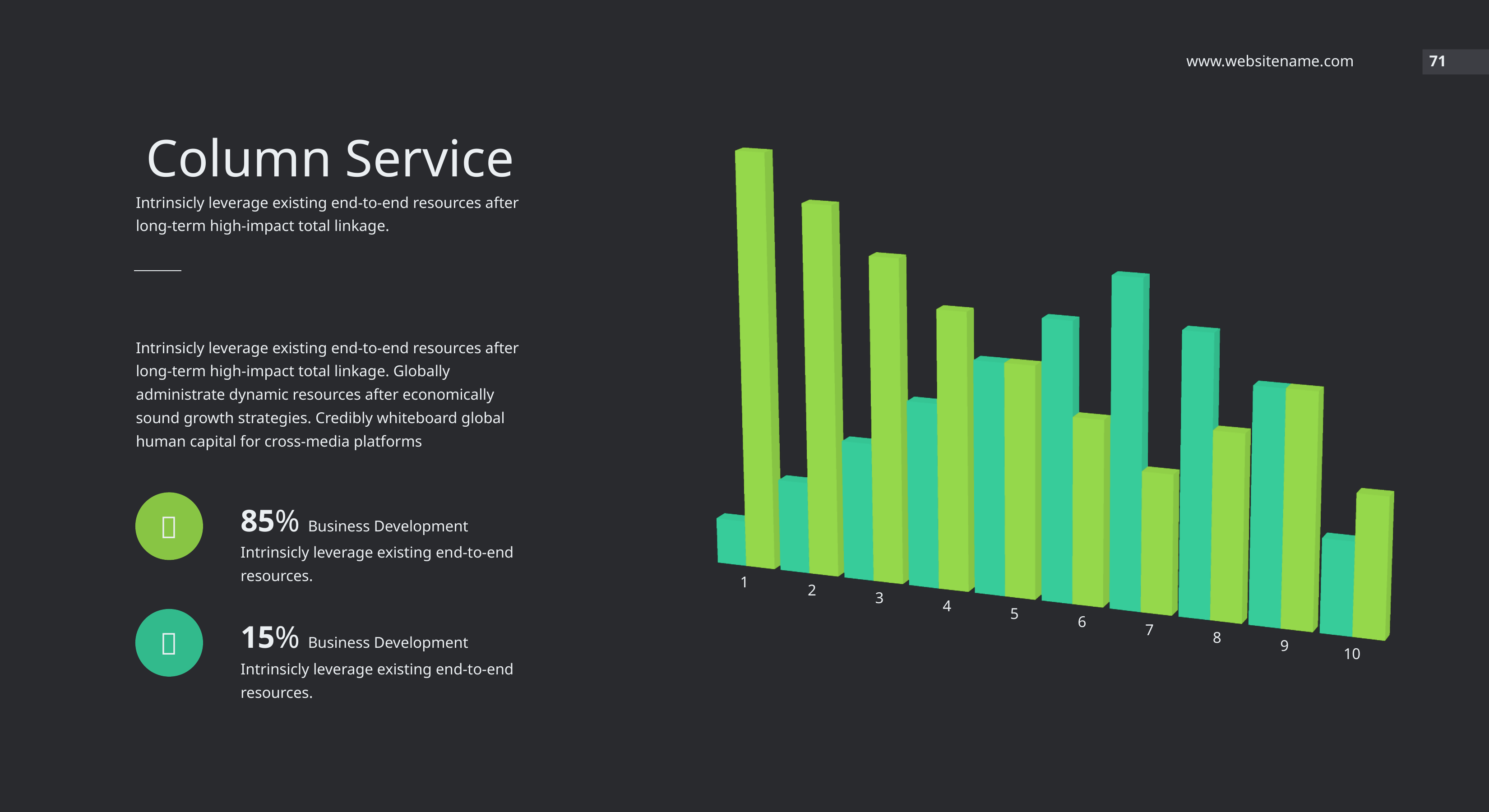
Do the teal bars rise or fall from category 1 to category 7? rise In category 3, which bar is taller, the green bar or the teal bar? green Which category has the tallest green bar? 1 How many categories are shown along the x axis of the chart? 10 What kind of chart is shown on the slide? bar chart What is the title of the slide containing the chart? Column Service Do the green bars rise or fall from category 1 to category 5? fall Which category has the shortest teal bar? 1 Which category has the tallest teal bar? 7 In category 7, which bar is taller, the green bar or the teal bar? teal How many differently coloured bar series are plotted in the chart? 2 In category 1, which bar is taller, the green bar or the teal bar? green